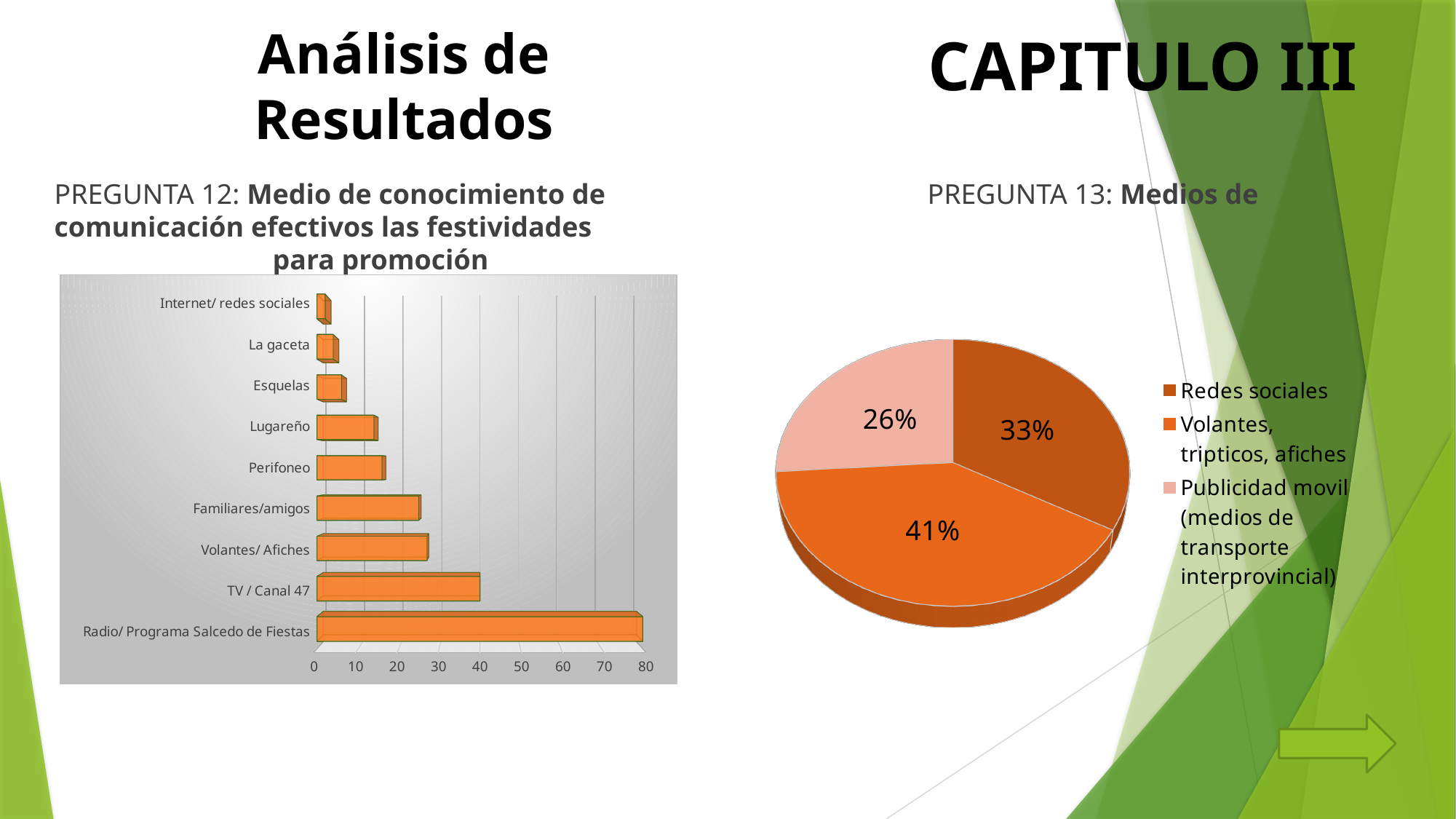
In the Pregunta 12 bar chart on the left, which category has the longest bar? Radio/ Programa Salcedo de Fiestas In the Pregunta 12 bar chart on the left, which category has the shortest bar? Internet/ redes sociales In the Pregunta 13 pie chart on the right, what percentage is shown for Volantes, tripticos, afiches? 41% In the Pregunta 12 bar chart on the left, how many categories are shown? 9 In the Pregunta 13 pie chart on the right, which slice is the smallest? Publicidad movil (medios de transporte interprovincial) In the Pregunta 12 bar chart on the left, is the value for TV / Canal 47 greater or less than 30? greater What kind of chart is the Pregunta 12 chart on the left? Bar chart In the Pregunta 12 bar chart on the left, is the value for Lugareño greater or less than 20? less In the Pregunta 12 bar chart on the left, is the value for Radio/ Programa Salcedo de Fiestas greater or less than 70? greater In the Pregunta 13 pie chart on the right, what is the difference in percentage points between the Volantes, tripticos, afiches slice and the Publicidad movil slice? 15 In the Pregunta 12 bar chart on the left, which is larger: the value for TV / Canal 47 or the value for Perifoneo? TV / Canal 47 In the Pregunta 13 pie chart on the right, what percentage is shown for Redes sociales? 33%